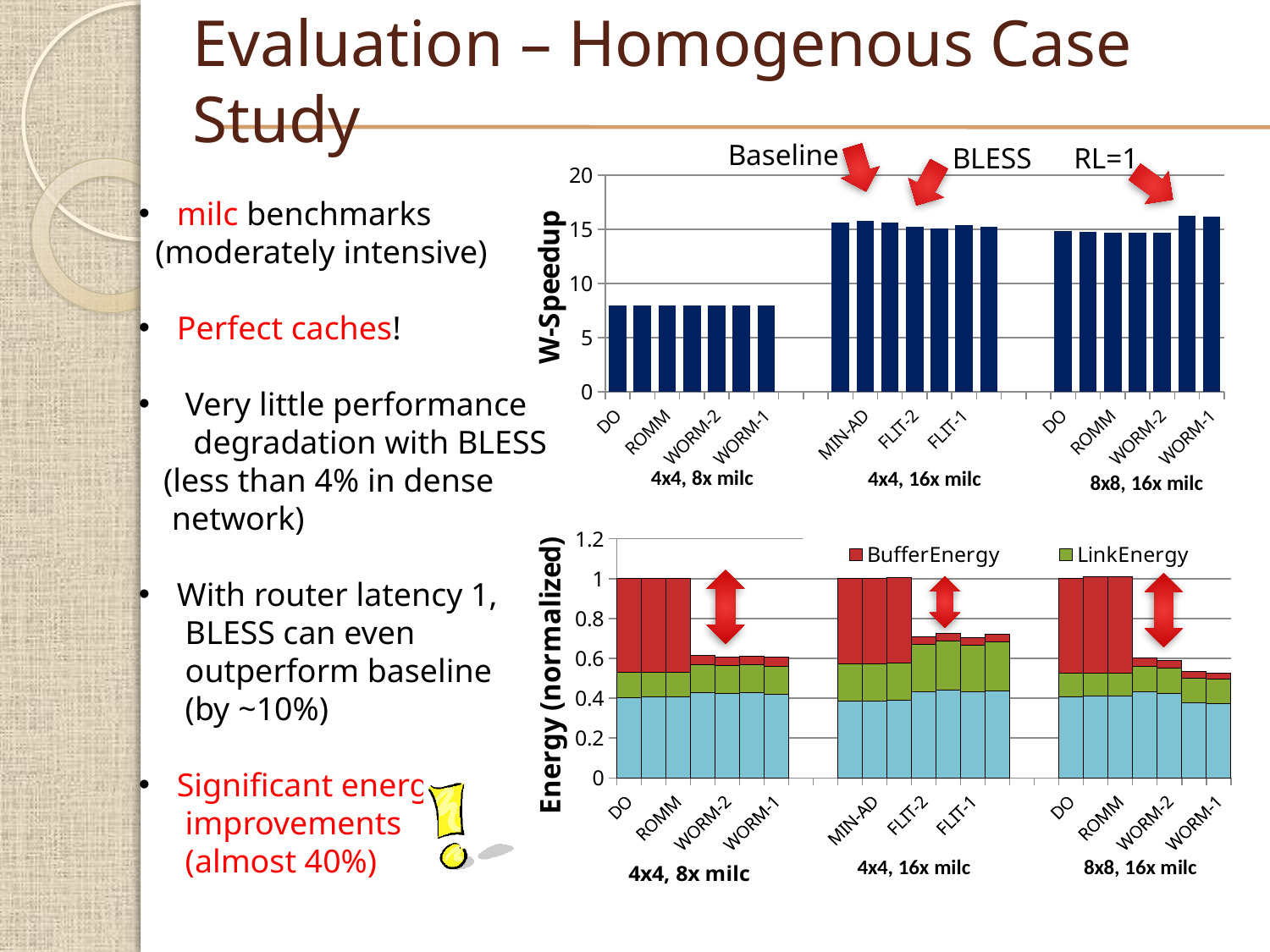
In the bottom chart (Energy (normalized)), how many series does the legend list? 2 What kind of chart is the top chart on the slide (W-Speedup)? bar chart In the bottom chart (Energy (normalized)), what are the two series named in the legend? BufferEnergy and LinkEnergy In the bottom chart (Energy (normalized)), is the total for WORM-2 in the 4x4, 8x milc group greater or less than 0.8? less In the bottom chart (Energy (normalized)), which is larger: the total for DO or the total for WORM-1 in the 8x8, 16x milc group? DO In the top chart (W-Speedup), is the value for MIN-AD in the 4x4, 16x milc group greater or less than 15? greater In the top chart (W-Speedup), how many labeled configuration groups are shown along the x axis? 3 In the top chart (W-Speedup), is the value for WORM-1 in the 8x8, 16x milc group greater or less than 15? greater What kind of chart is the bottom chart on the slide (Energy (normalized))? stacked bar chart In the top chart (W-Speedup), which is larger: the value for MIN-AD in the 4x4, 16x milc group or the value for DO in the 4x4, 8x milc group? MIN-AD in the 4x4, 16x milc group What is the y-axis title of the top chart? W-Speedup